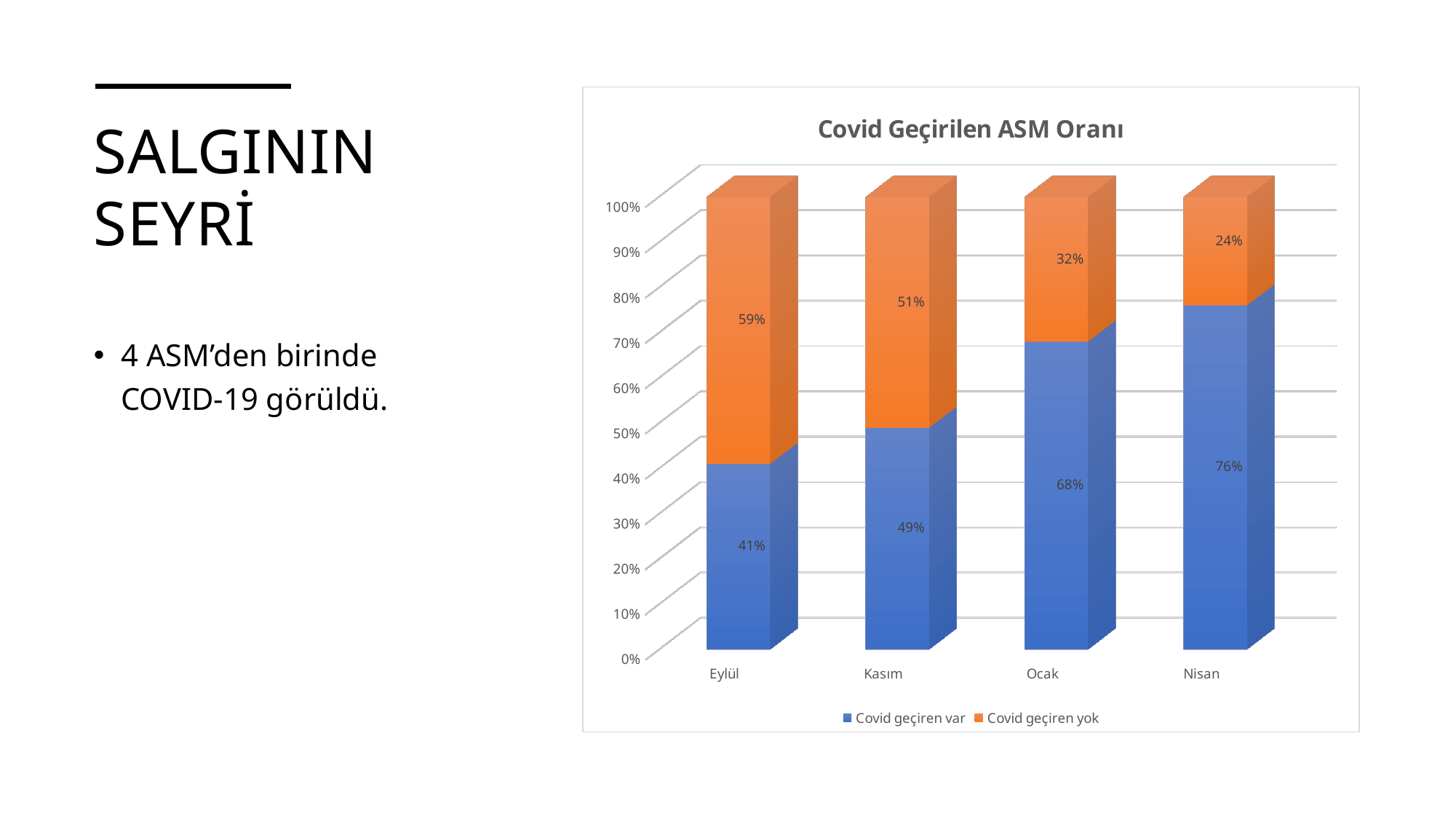
What is the value for 'Covid geçiren var' in Nisan? 76% What is the value for 'Covid geçiren yok' in Ocak? 32% How many series does the legend list? 2 What is the value for 'Covid geçiren var' in Eylül? 41% Which is larger: 'Covid geçiren var' in Ocak or 'Covid geçiren yok' in Ocak? Covid geçiren var Which month has the highest value for 'Covid geçiren var'? Nisan What is the difference between the 'Covid geçiren var' values for Nisan and Eylül? 35% Does the 'Covid geçiren var' value rise or fall from Eylül to Nisan? Rise Which month has the lowest value for 'Covid geçiren yok'? Nisan What kind of chart is shown? Stacked bar chart How many months are shown on the x axis? 4 What is the value for 'Covid geçiren yok' in Kasım? 51%